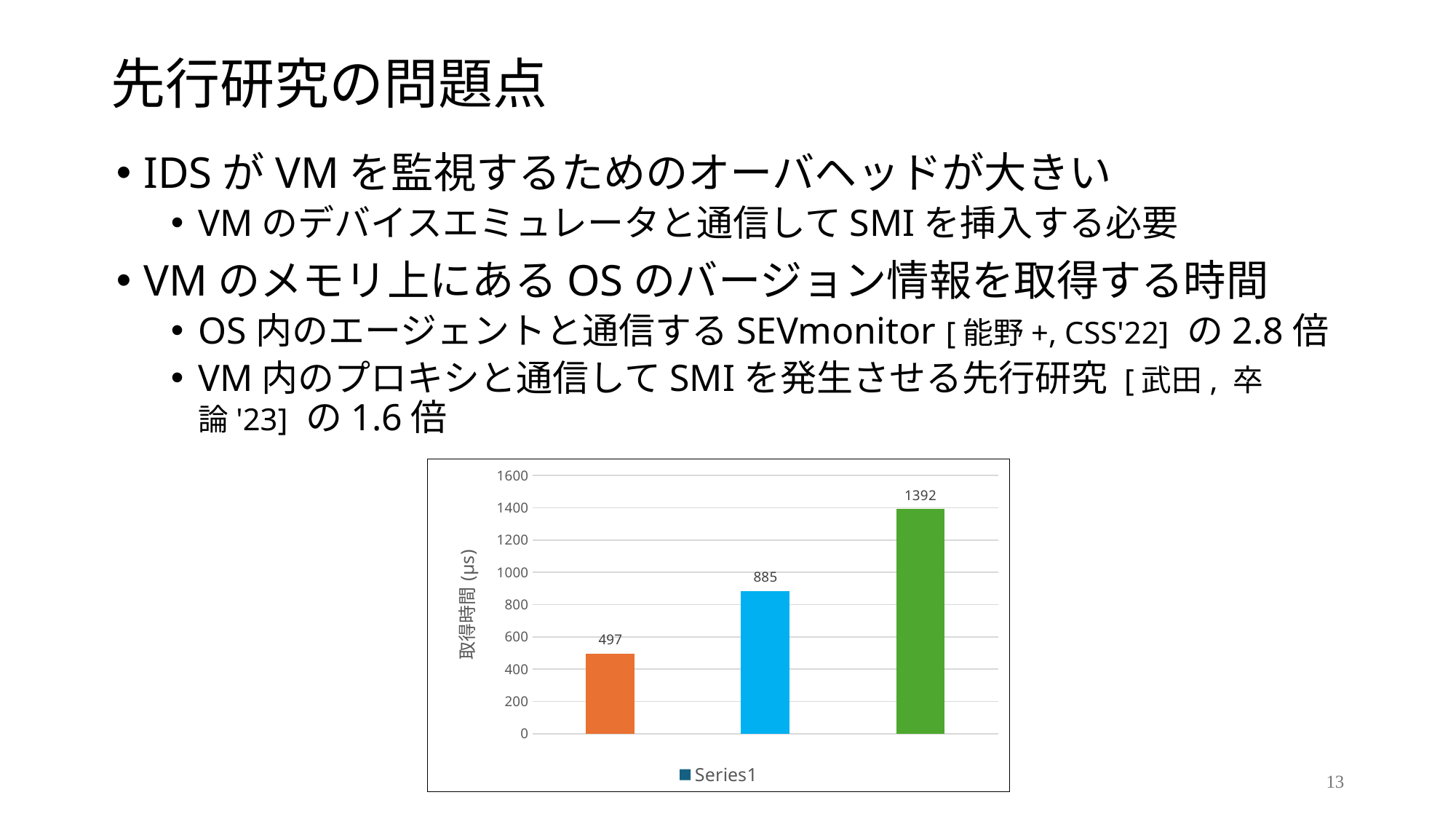
What is the difference between the blue bar's value and the orange bar's value? 388 How many series does the legend list? 1 What is the value shown on the leftmost (orange) bar? 497 Which bar has the highest value: the orange, blue, or green bar? green What kind of chart is shown on the slide? bar chart How many bars are plotted in the chart? 3 Which bar has the lowest value: the orange, blue, or green bar? orange What is the value shown on the rightmost (green) bar? 1392 Is the value of the green bar greater or less than 1200? greater What is the difference between the green bar's value and the orange bar's value? 895 What is the value shown on the middle (blue) bar? 885 Which is larger, the value of the blue bar or the value of the orange bar? blue bar